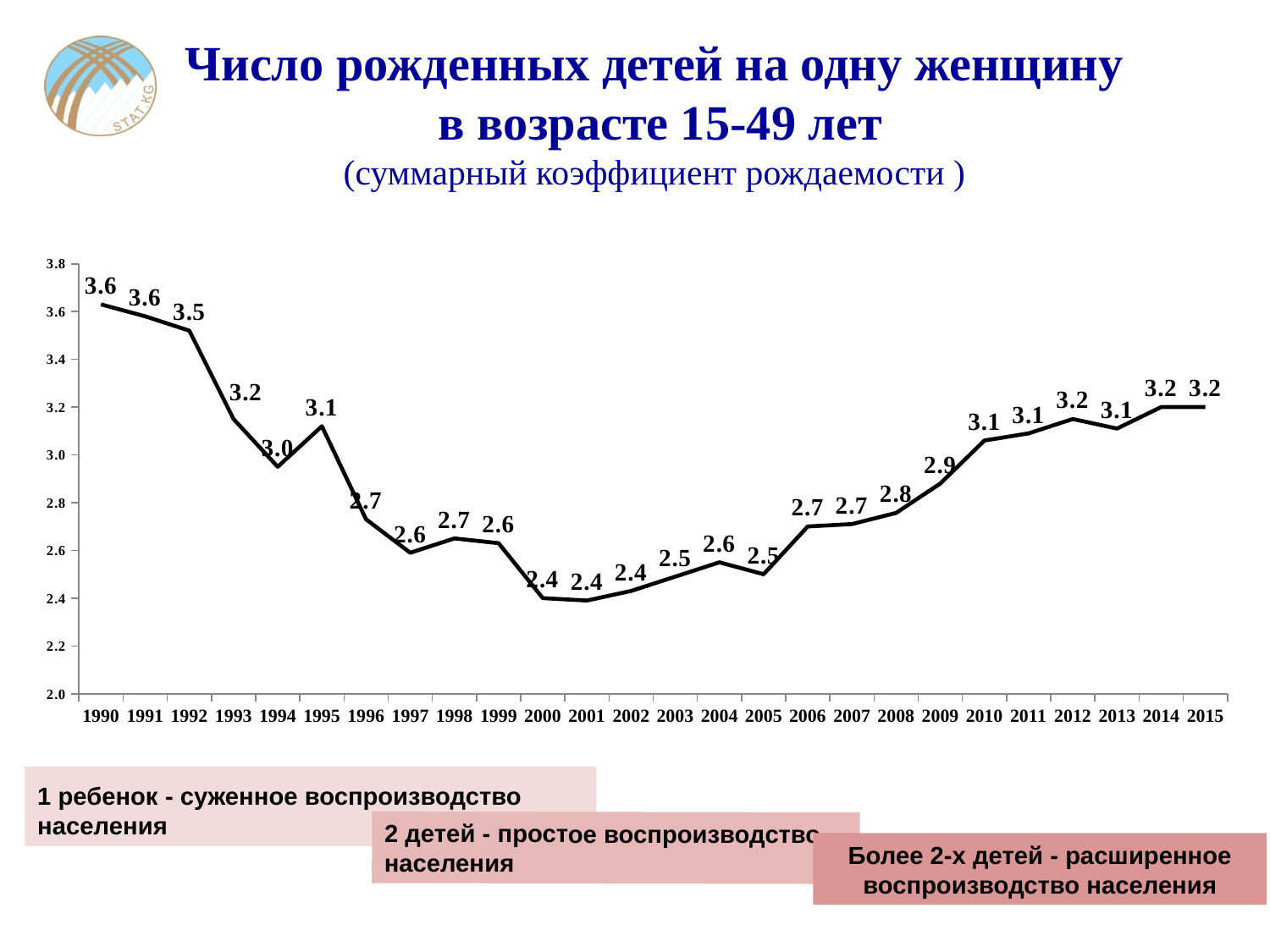
Which year has the larger value, 1993 or 2008? 1993 What is the value for 2009? 2.9 What is the lowest value plotted on the chart? 2.4 What is the difference between the value for 1990 and the value for 2000? 1.2 What is the value for 1992? 3.5 Do the values rise or fall from 2005 to 2012? rise How many years are plotted on the x axis? 26 What type of chart is shown on the slide? line chart What is the subtitle in parentheses under the chart title? суммарный коэффициент рождаемости Do the values rise or fall from 1990 to 1994? fall What is the highest value plotted on the chart? 3.6 What is the value for 2015? 3.2